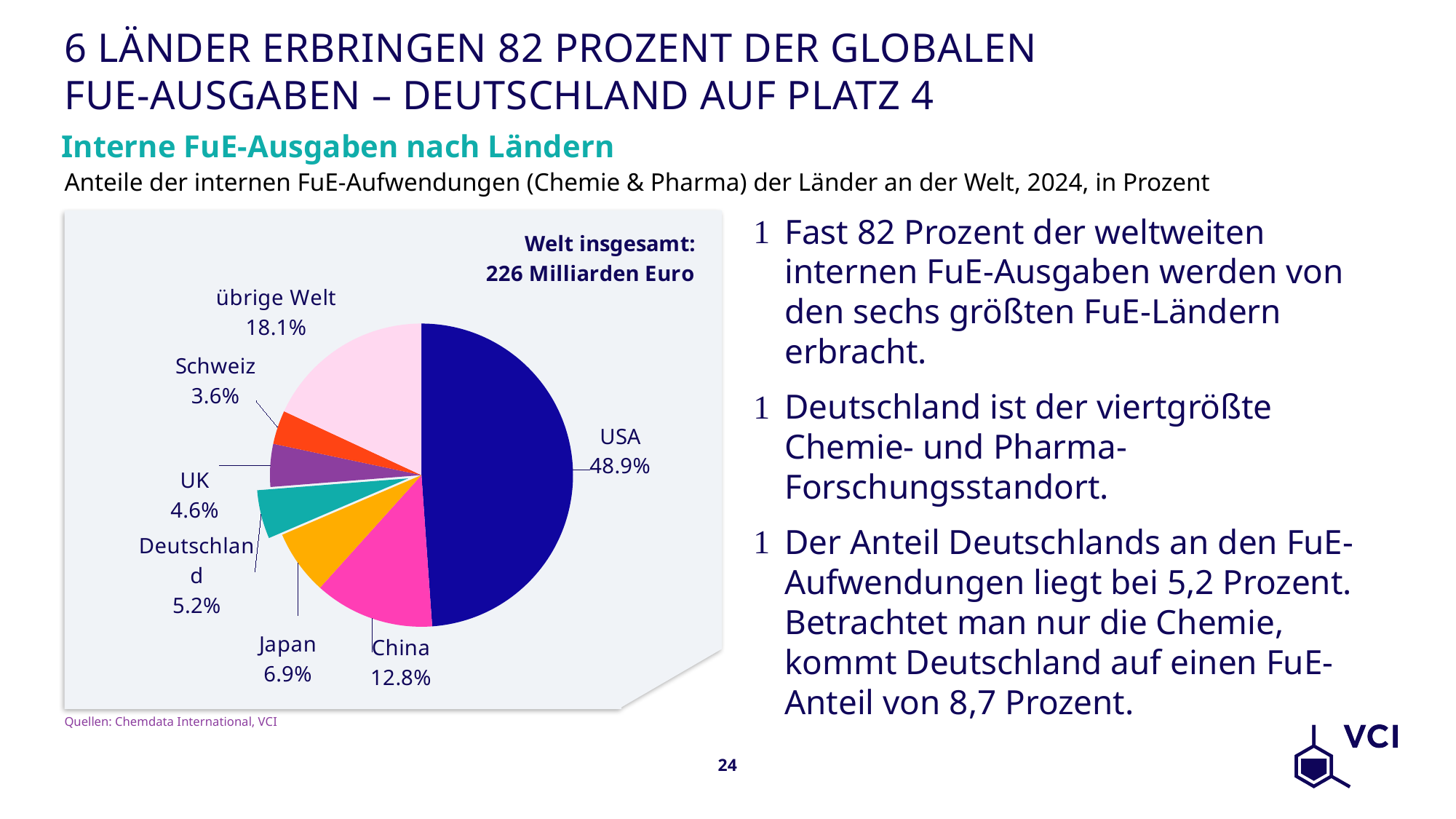
What share of the pie does the USA hold? 48.9% What is the title of the chart? Interne FuE-Ausgaben nach Ländern What is the world total stated on the chart? 226 Milliarden Euro What is the difference between the shares of China and Japan? 5.9% How many slices does the pie chart have? 7 Which is larger, the share of UK or the share of Deutschland? Deutschland Which named country has the smallest slice? Schweiz What share is shown for Deutschland? 5.2% What is the value shown for China? 12.8% What kind of chart is shown on the slide? Pie chart Which slice of the pie is the largest? USA What is the value shown for Schweiz? 3.6%